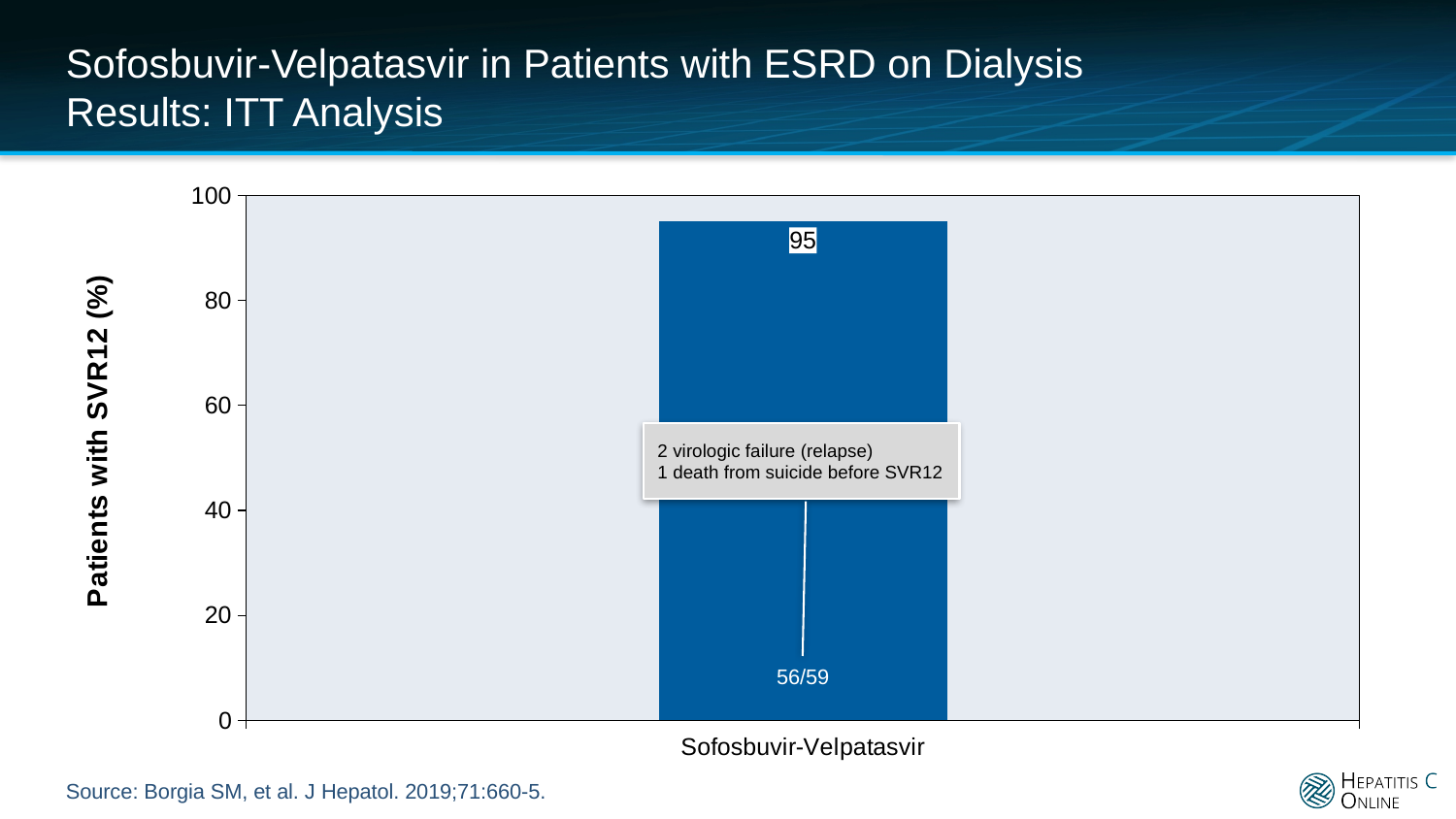
What is the category label on the x axis? Sofosbuvir-Velpatasvir What fraction of patients (n/N) is printed on the Sofosbuvir-Velpatasvir bar? 56/59 What is the label of the y axis? Patients with SVR12 (%) According to the callout on the chart, how many deaths from suicide before SVR12 occurred? 1 What is the SVR12 rate (%) shown for Sofosbuvir-Velpatasvir? 95 Is the value for Sofosbuvir-Velpatasvir greater or less than 80? greater Is the value for Sofosbuvir-Velpatasvir greater or less than 100? less How many bars are plotted in the chart? 1 What is the maximum value shown on the y axis? 100 What kind of chart is shown on the slide? bar chart According to the callout on the chart, how many virologic failures (relapse) occurred? 2